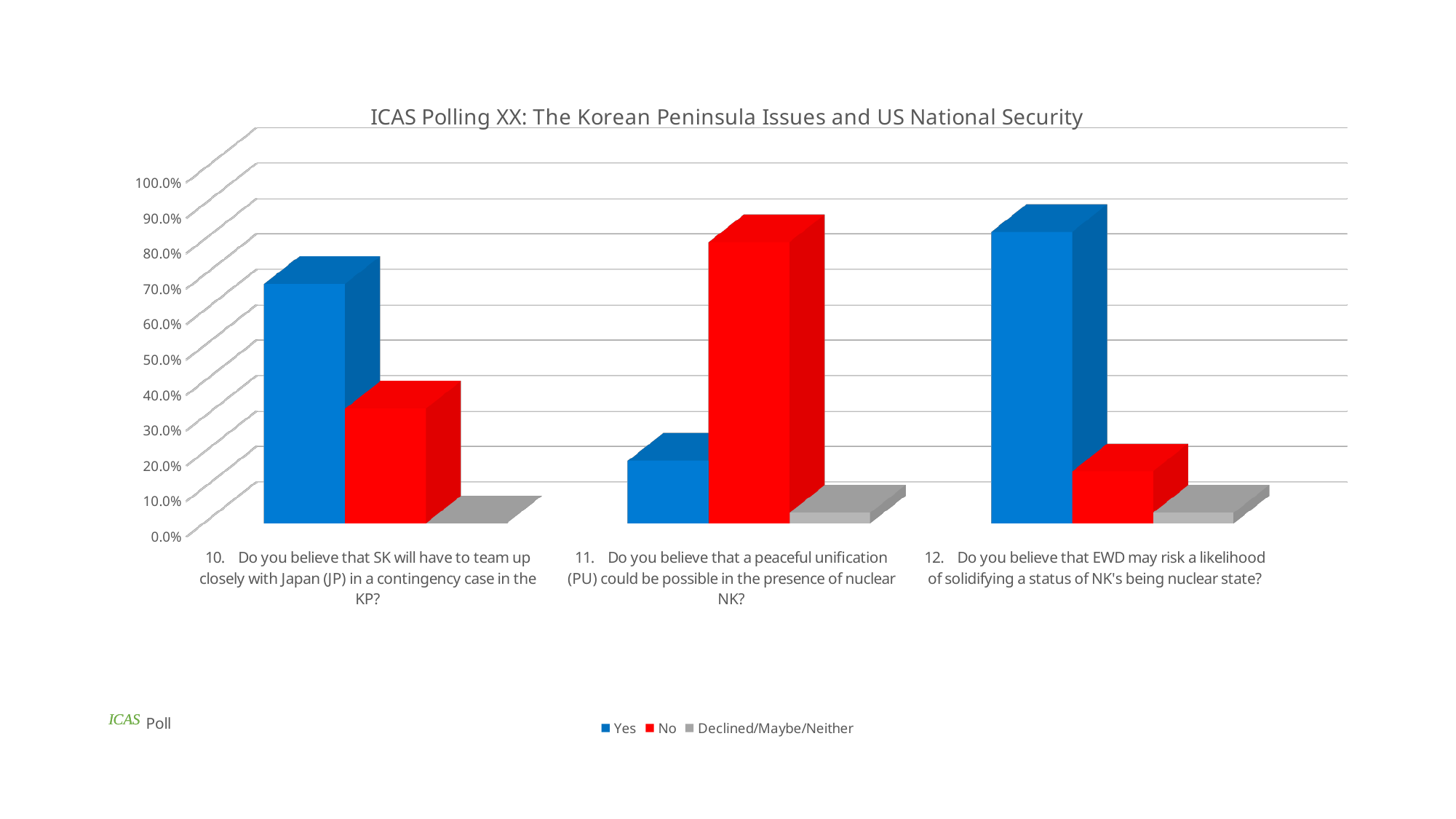
Is the Yes value for question 11 greater or less than 30.0%? less For question 12 (EWD risking solidifying NK's nuclear state status), which is larger, Yes or No? Yes For question 10 (SK teaming up with Japan in a contingency), which is larger, Yes or No? Yes How many poll questions (categories) are shown on the x axis? 3 Which poll question has the lowest Yes value? 11. Do you believe that a peaceful unification (PU) could be possible in the presence of nuclear NK? For question 11 (peaceful unification in the presence of nuclear NK), which is larger, Yes or No? No Is the No value for question 11 greater or less than 70.0%? greater Which poll question has the highest Yes value? 12. Do you believe that EWD may risk a likelihood of solidifying a status of NK's being nuclear state? What kind of chart is shown on the slide? bar chart What is the title of the chart? ICAS Polling XX: The Korean Peninsula Issues and US National Security How many series does the legend list? 3 Which series is shown in red in the legend? No